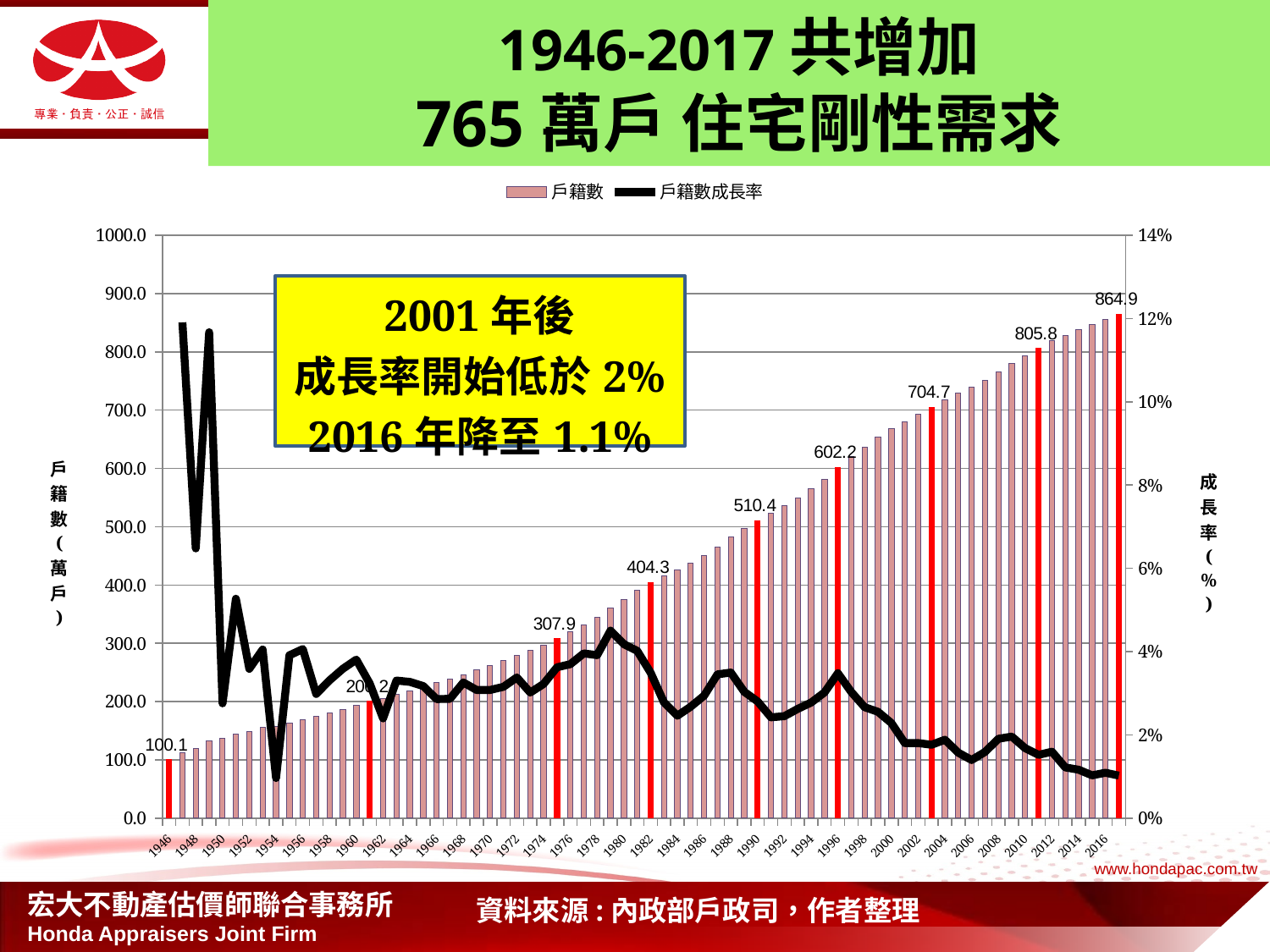
What is the 戶籍數 value shown for 1946? 100.1 Do the 戶籍數 bars rise or fall from 1946 to 2017? rise How many series does the legend list? 2 Which year has the highest 戶籍數 bar? 2017 What is the 戶籍數 value labelled for 2017? 864.9 What is the 戶籍數 value labelled for 1996? 602.2 Is the 戶籍數成長率 value for 2016 greater or less than 2%? less What is the 戶籍數 value labelled for 1982? 404.3 What is the difference between the 戶籍數 values labelled for 2011 and 2003? 101.1 Which is larger, the 戶籍數 value for 1990 or for 1975? 1990 What is the difference between the 戶籍數 values labelled for 2017 and 1946? 764.8